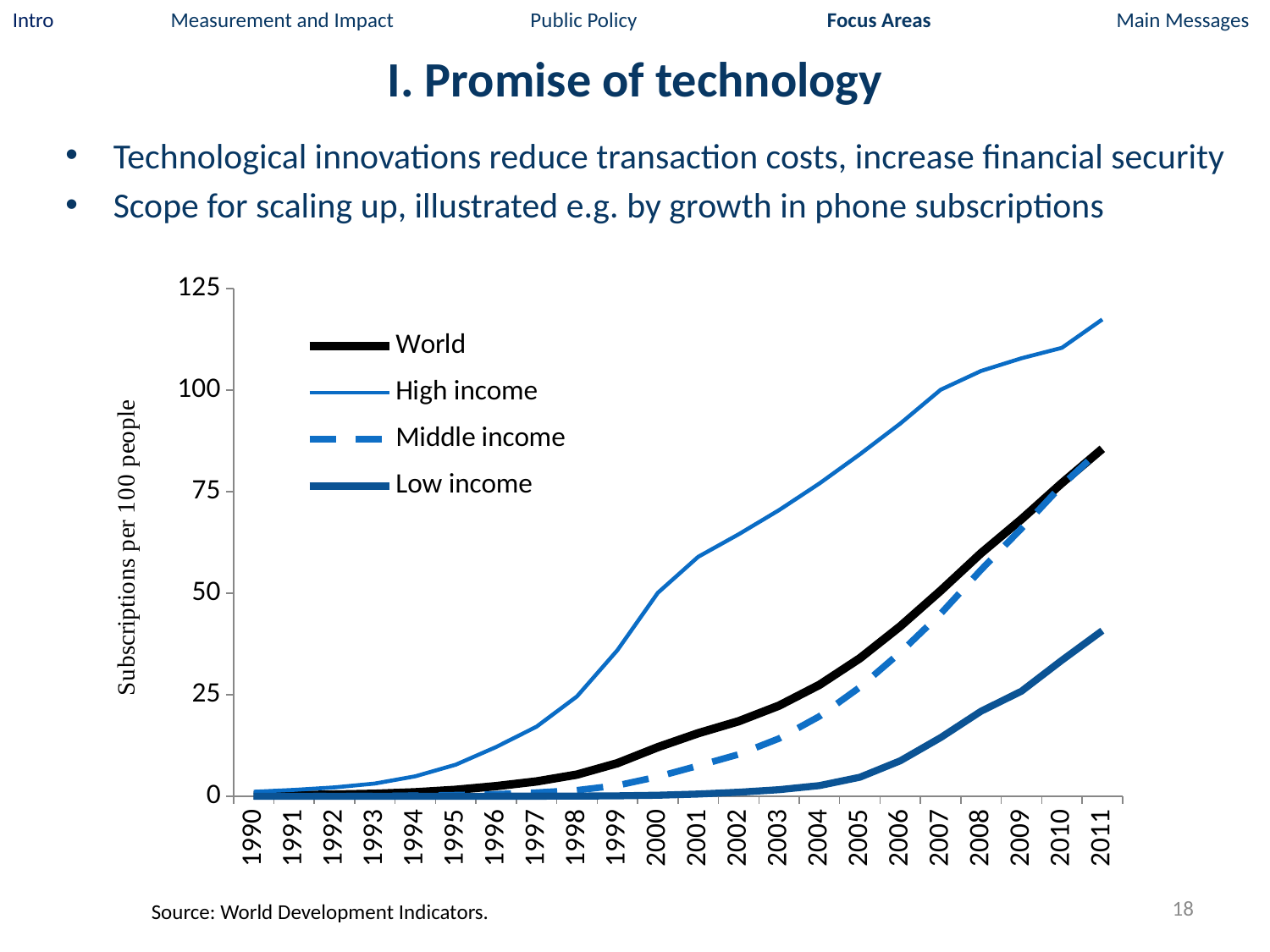
Is the value for High income in 2011 greater or less than 100? greater Is the value for World in 2011 greater or less than 75? greater Which series has the highest value in 2011? High income What is the label on the y axis? Subscriptions per 100 people Do the values for High income rise or fall from 1990 to 2011? rise What kind of chart is shown on the slide? line chart How many years are shown along the x axis? 22 Is the value for High income in 2000 greater or less than 25? greater Which series has the lowest value in 2011? Low income In 2005, which is larger: the value for World or the value for Low income? World How many series does the legend list? 4